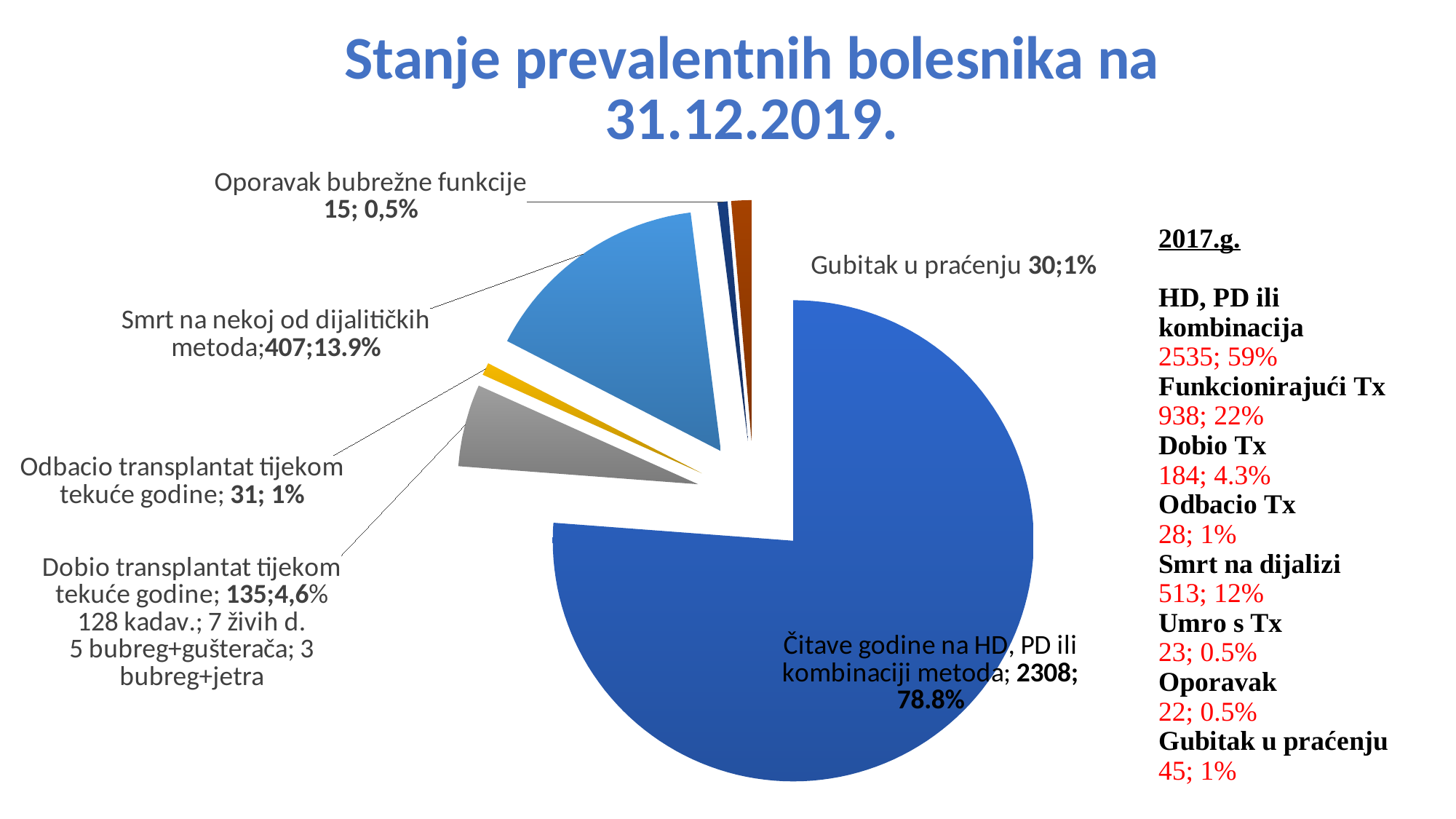
How many slices does the pie chart have? 6 What is the title of the slide containing the pie chart? Stanje prevalentnih bolesnika na 31.12.2019. What share of the pie does "Smrt na nekoj od dijalitičkih metoda" represent? 13.9% What is the value for "Smrt na nekoj od dijalitičkih metoda"? 407 What is the value for "Čitave godine na HD, PD ili kombinaciji metoda"? 2308 What is the value for "Dobio transplantat tijekom tekuće godine"? 135 Which category has the smallest slice of the pie? Oporavak bubrežne funkcije What is the value for "Oporavak bubrežne funkcije"? 15 What kind of chart is shown on the slide? pie chart What is the difference between the values for "Smrt na nekoj od dijalitičkih metoda" and "Dobio transplantat tijekom tekuće godine"? 272 What share of the pie does "Čitave godine na HD, PD ili kombinaciji metoda" represent? 78.8% Which category has the largest slice of the pie? Čitave godine na HD, PD ili kombinaciji metoda